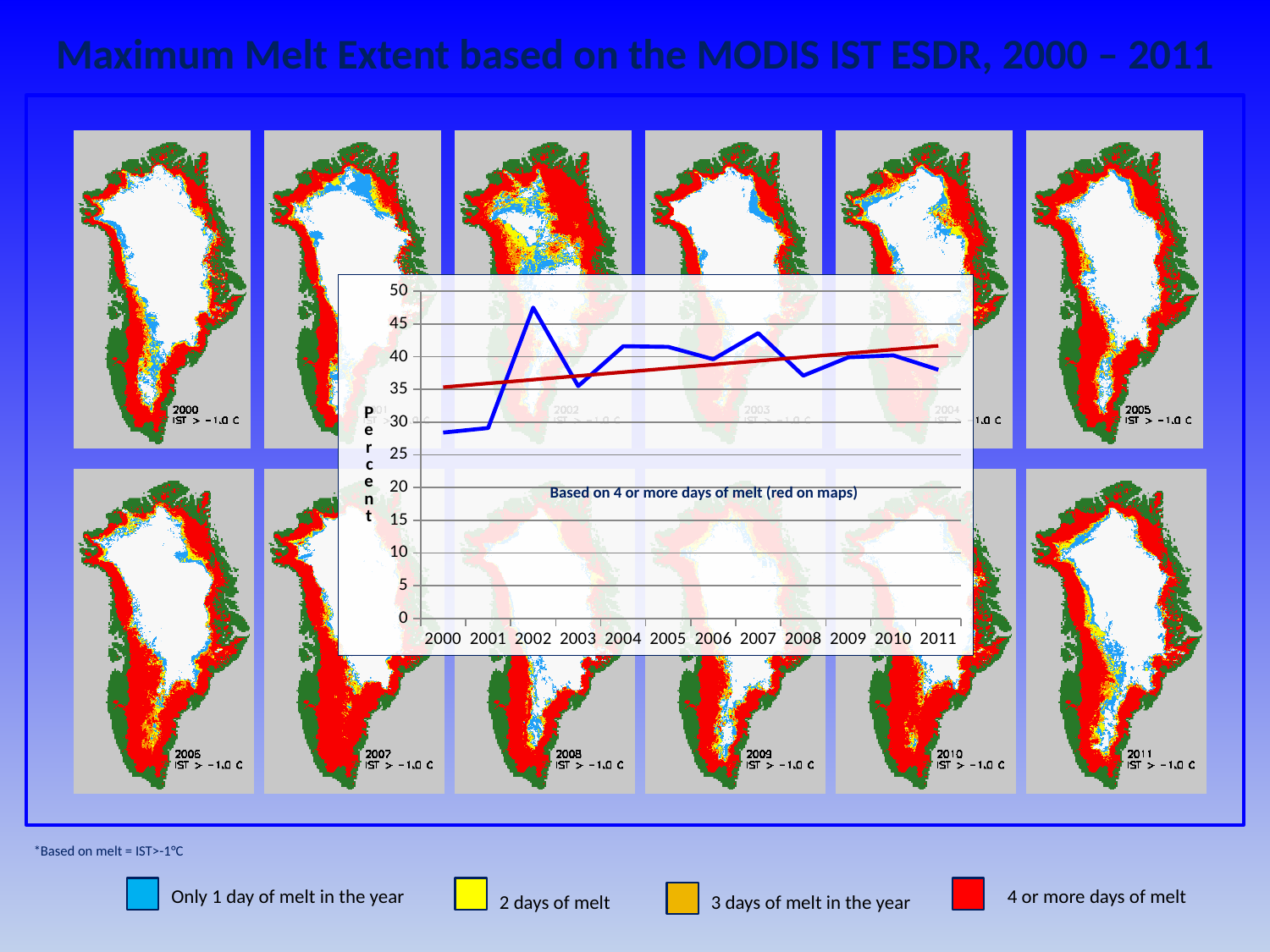
Is the value for 2002 greater or less than 45? greater How many years are plotted along the x axis of the chart? 12 Is the value for 2007 greater or less than 40? greater Which year has the highest value on the blue line? 2002 Which year has the larger value, 2007 or 2008? 2007 What kind of chart is shown on the slide? line chart Is the value for 2003 greater or less than 40? less Which year has the larger value, 2002 or 2003? 2002 What is the label on the y axis of the chart? Percent According to the red trend line, do the values generally rise or fall from 2000 to 2011? rise Which year has the lowest value on the blue line? 2000